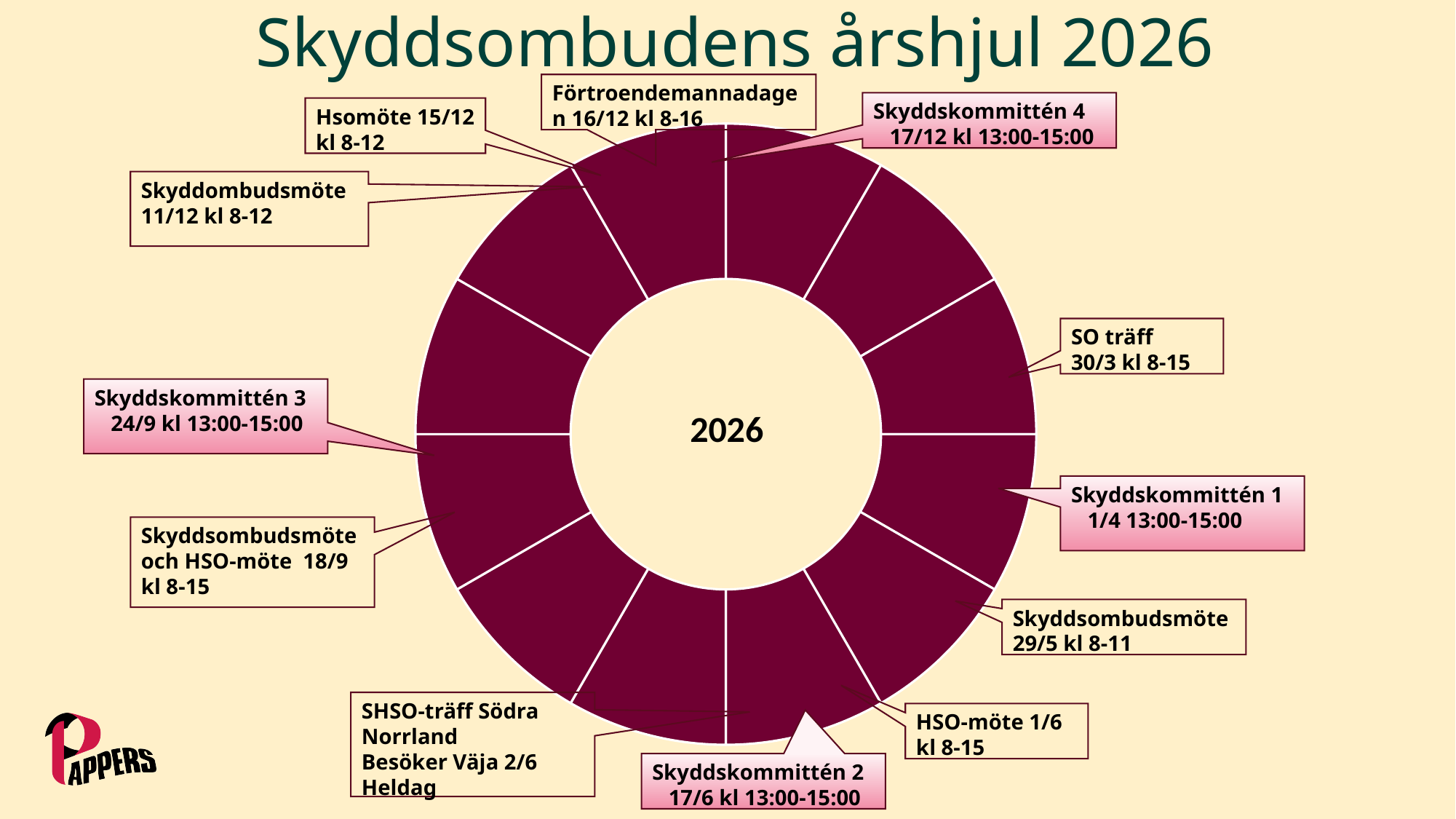
What date and time does the callout give for Förtroendemannadagen? 16/12 kl 8-16 What is the title of the slide? Skyddsombudens årshjul 2026 What date and time does the callout give for Skyddskommittén 3? 24/9 kl 13:00-15:00 What text is shown in the centre of the ring chart? 2026 What kind of chart is shown on the slide? Doughnut chart What time is the Skyddsombudsmöte on 29/5 scheduled for? kl 8-11 When is the HSO-möte scheduled according to the callout at the bottom right? 1/6 kl 8-15 What date and time does the callout give for Skyddskommittén 4? 17/12 kl 13:00-15:00 When is the SO träff scheduled according to the callout? 30/3 kl 8-15 On what date and time is Skyddskommittén 1 scheduled according to the callout? 1/4 13:00-15:00 What date and time does the callout give for Skyddskommittén 2? 17/6 kl 13:00-15:00 How many segments does the ring chart have? 12